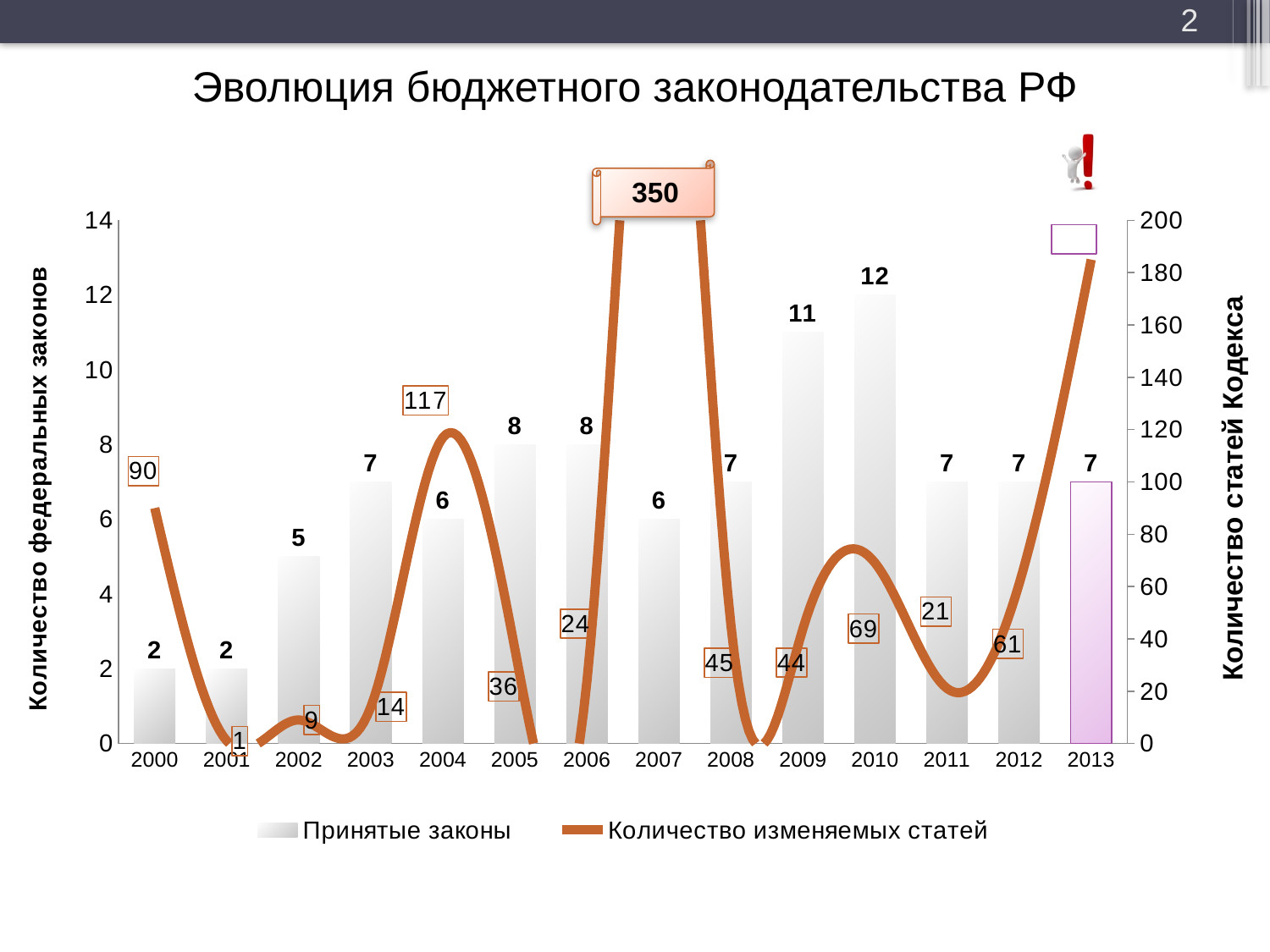
What kinds of chart are combined on this slide? Bar chart and line chart Which is larger, the Количество изменяемых статей value for 2000 or for 2012? 2000 How many years are shown on the x axis? 14 How many series does the legend list? 2 Which year has the lowest value for Количество изменяемых статей? 2001 What is the value of Принятые законы for 2010? 12 Which year has the highest value for Принятые законы? 2010 What is the value of Количество изменяемых статей for 2004? 117 Does the Принятые законы value rise or fall from 2008 to 2010? Rise What is the difference between the Принятые законы values for 2010 and 2009? 1 What is the value of Количество изменяемых статей for 2007? 350 What is the title of the chart? Эволюция бюджетного законодательства РФ